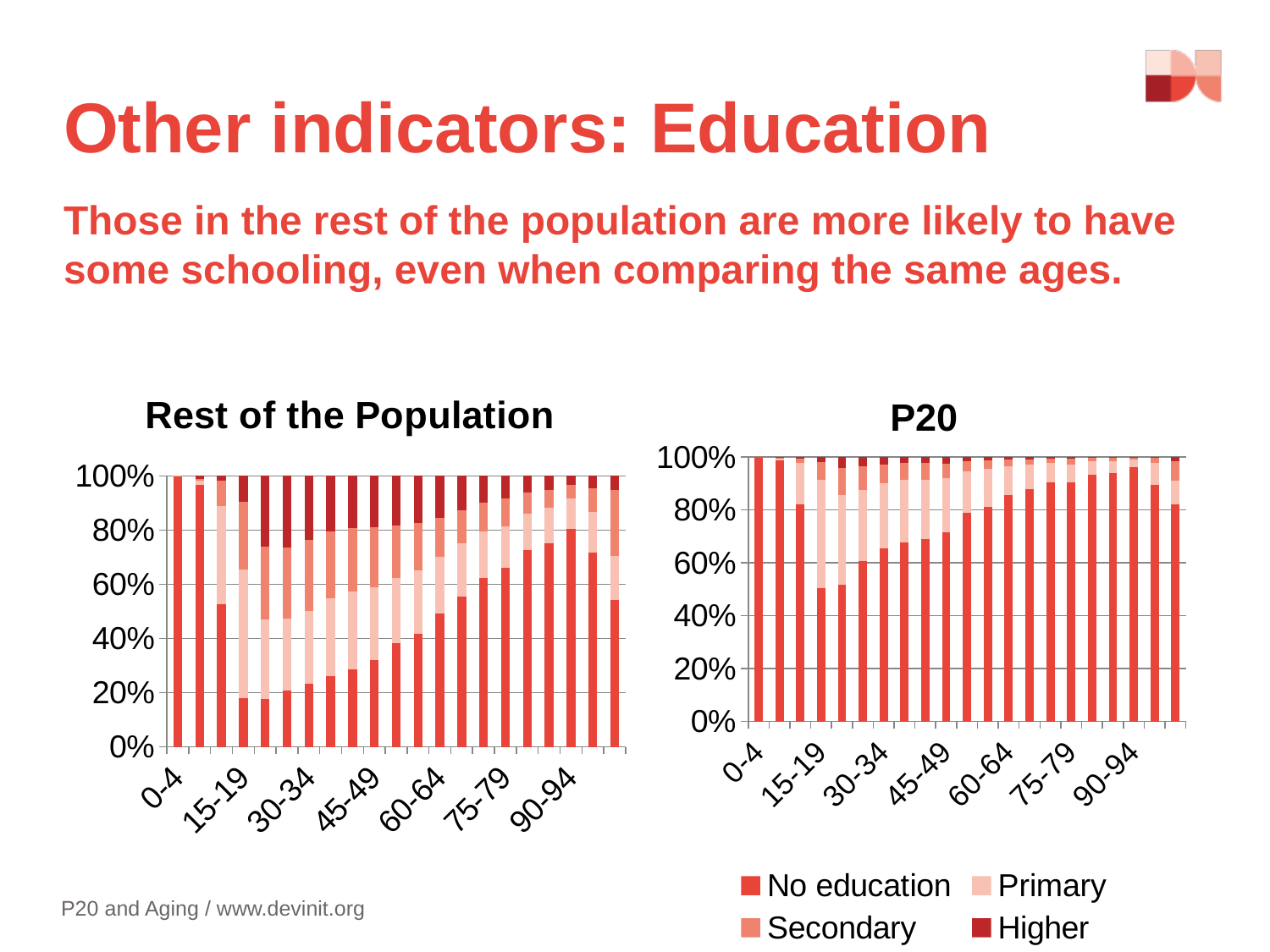
What kind of chart is the "Rest of the Population" chart? Stacked bar chart In the "Rest of the Population" chart, is the No education share for the 75-79 age group greater or less than 40%? greater In the "Rest of the Population" chart, does the No education share generally rise or fall as age increases from 15-19 to 90-94? Rise In the "Rest of the Population" chart, is the No education share for the 15-19 age group greater or less than 20%? less What are the titles of the two charts on the slide? Rest of the Population and P20 How many series does the legend list? 4 In the "Rest of the Population" chart, is the No education share for the 45-49 age group greater or less than 40%? less In the "P20" chart, does the No education share generally rise or fall as age increases from 15-19 to 90-94? Rise What are the four education categories listed in the legend? No education, Primary, Secondary, Higher Which chart shows a larger No education share for the 30-34 age group, "Rest of the Population" or "P20"? P20